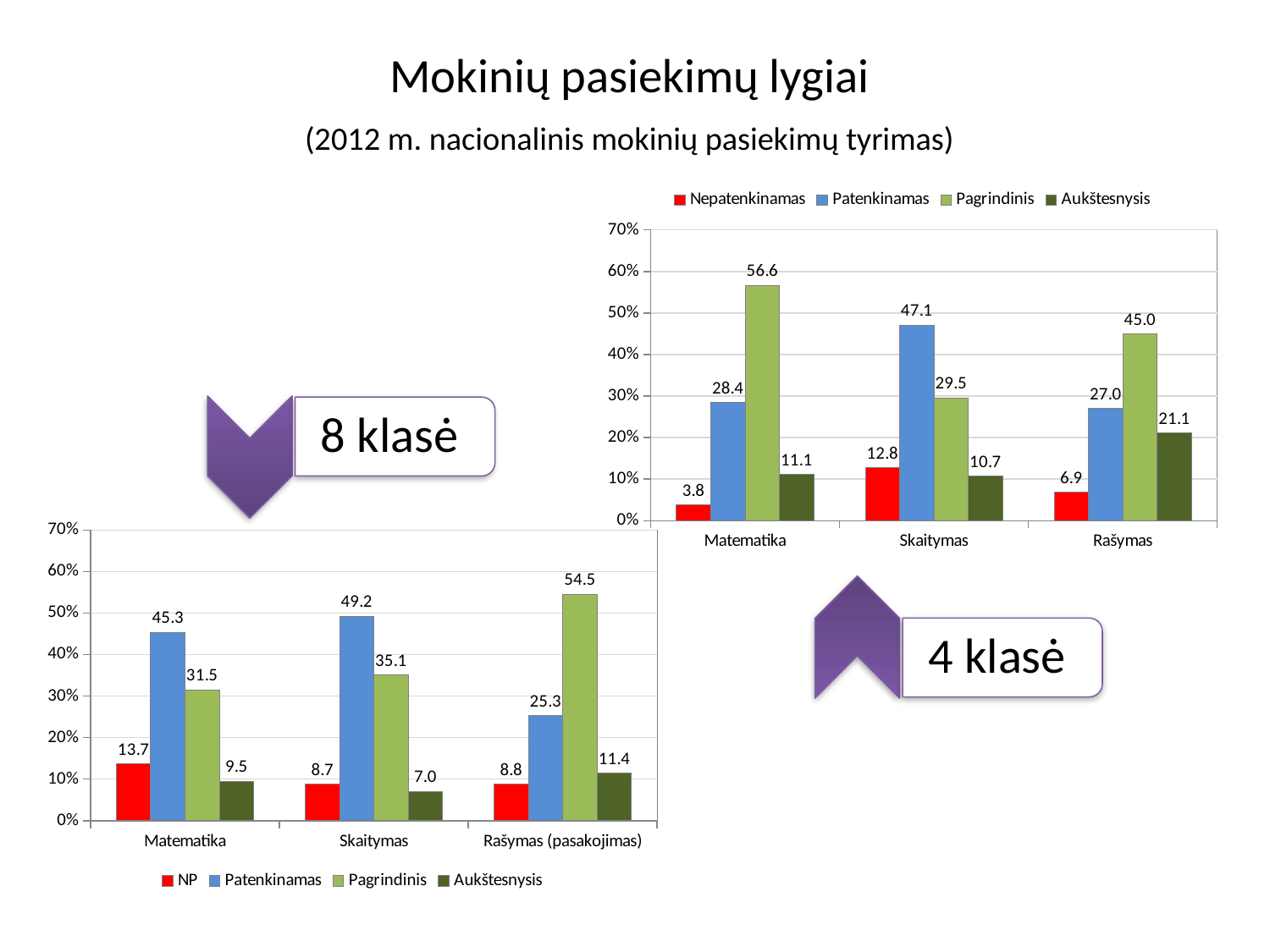
How many categories are shown on the x axis of the 4 klasė chart (top right)? 3 How many series does the legend of the 8 klasė chart (bottom left) list? 4 In the 4 klasė chart (top right), what is the value for Aukštesnysis in Rašymas? 21.1 In the 8 klasė chart (bottom left), what is the difference between the Patenkinamas and Pagrindinis values in Matematika? 13.8 In the 8 klasė chart (bottom left), what is the value for Patenkinamas in Skaitymas? 49.2 What type of chart is the 4 klasė chart (top right)? Bar chart In the 8 klasė chart (bottom left), what is the first legend entry? NP In the 8 klasė chart (bottom left), which category has the highest Pagrindinis value? Rašymas (pasakojimas) In the 4 klasė chart (top right), which is larger in Skaitymas: Patenkinamas or Pagrindinis? Patenkinamas In the 4 klasė chart (top right), which category has the lowest Nepatenkinamas value? Matematika In the 8 klasė chart (bottom left), is the Pagrindinis value for Rašymas (pasakojimas) greater or less than 50%? greater In the 4 klasė chart (top right), what is the value for Pagrindinis in Matematika? 56.6